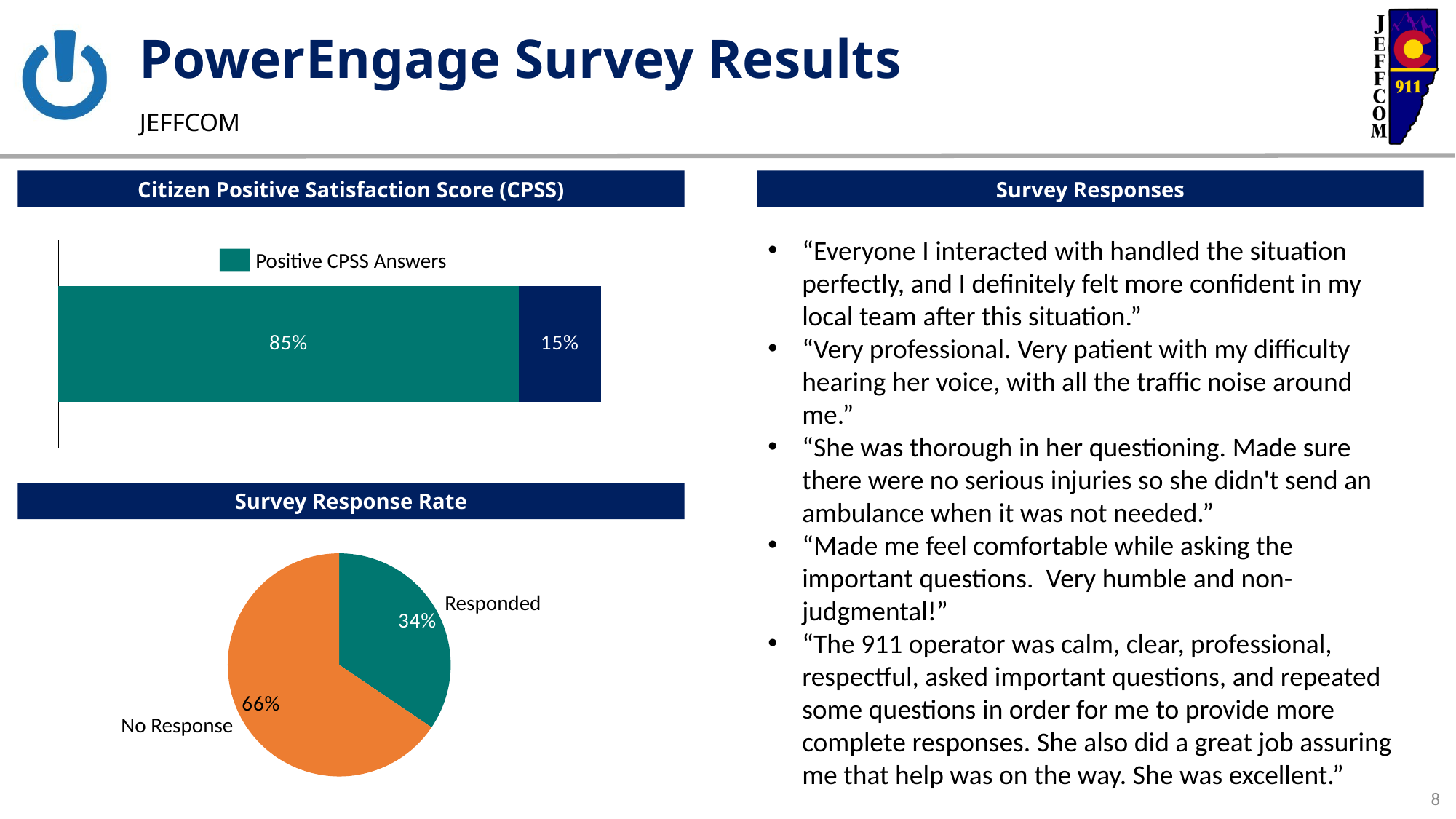
What kind of chart is the Survey Response Rate chart? pie chart In the Citizen Positive Satisfaction Score (CPSS) chart, what is the difference between the two segments of the bar? 70% In the Survey Response Rate chart, which slice is larger, Responded or No Response? No Response In the Citizen Positive Satisfaction Score (CPSS) chart, what is the only entry listed in the legend? Positive CPSS Answers How many slices does the Survey Response Rate pie chart have? 2 In the Citizen Positive Satisfaction Score (CPSS) chart, what is the total of the two segments of the stacked bar? 100% In the Survey Response Rate chart, what is the difference between the No Response and Responded shares? 32% In the Citizen Positive Satisfaction Score (CPSS) chart, what percentage is shown for the dark blue segment? 15% In the Survey Response Rate chart, what percentage Responded? 34% In the Survey Response Rate chart, what percentage is No Response? 66% In the Citizen Positive Satisfaction Score (CPSS) chart, what percentage is shown for Positive CPSS Answers? 85% What kind of chart is the Citizen Positive Satisfaction Score (CPSS) chart? bar chart